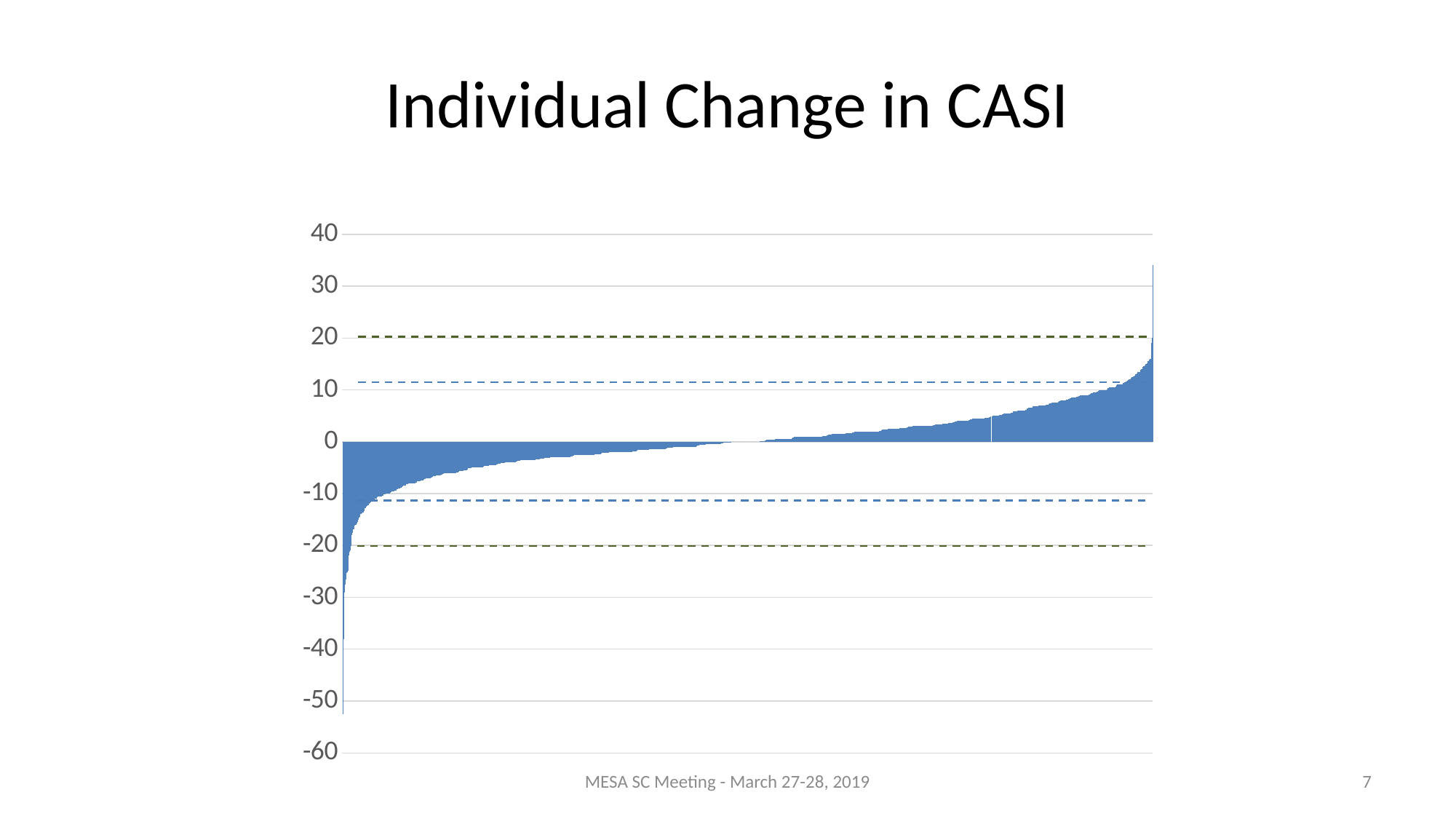
Is the value of the tallest bar at the right end of the chart greater or less than 30? greater Do the bar values rise or fall moving from left to right along the x axis? rise What is the title of the chart on the slide? Individual Change in CASI Is the value of the lowest bar at the left end of the chart greater or less than -40? less What kind of chart is shown on the slide? bar chart Which end of the chart has the bar with the larger absolute value, the left end or the right end? left end Are the bars on the left side of the chart above or below zero? below What is the lowest value shown on the vertical axis? -60 What is the highest value shown on the vertical axis? 40 Is the value of the tallest bar at the right end of the chart greater or less than 40? less